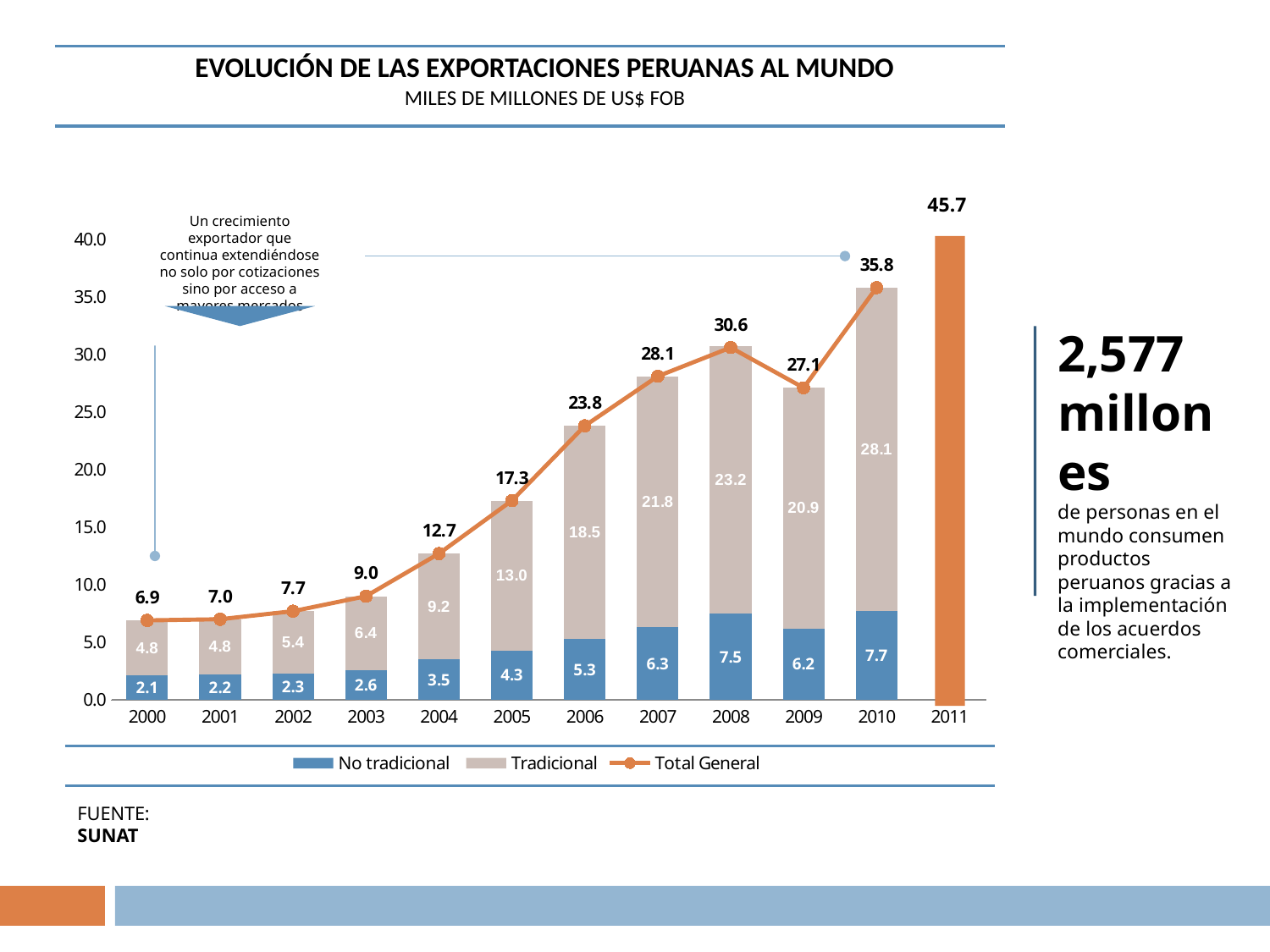
What is the No tradicional value for 2005? 4.3 What value is shown for 2011? 45.7 Which year between 2000 and 2010 has the highest Tradicional value? 2010 Does the Total General value generally rise or fall from 2000 to 2008? rise Which year has the lowest Total General value? 2000 How many years are shown on the x axis? 12 What is the Tradicional value for 2010? 28.1 What is the Total General value for 2008? 30.6 What is the source cited below the chart? SUNAT How many series does the legend list? 3 Which is larger, the No tradicional value for 2008 or for 2009? 2008 What is the difference between the Total General values for 2010 and 2009? 8.7